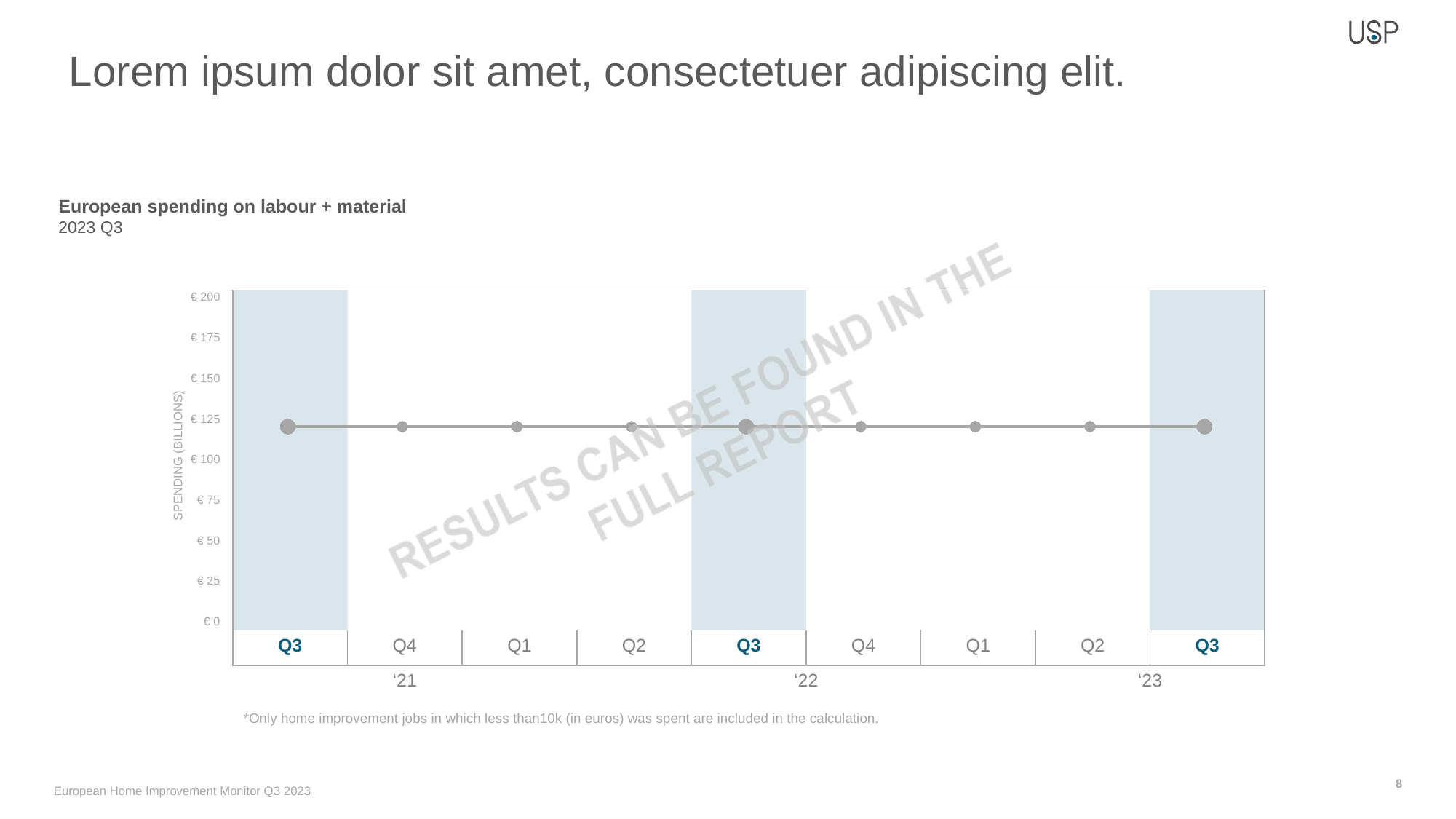
Is the value for Q3 '23 greater or less than € 150? less Is the value for Q3 '21 greater or less than € 100? greater What is the title of the chart? European spending on labour + material Which quarter label appears three times along the x axis? Q3 What is the highest value shown on the vertical axis? € 200 Do the values rise, fall, or stay flat from Q3 '21 to Q3 '23? stay flat What kind of chart is shown on the slide? line chart How many data points are plotted on the line? 9 Is the value for Q4 '22 greater or less than € 75? greater What is the label on the vertical axis? SPENDING (BILLIONS)